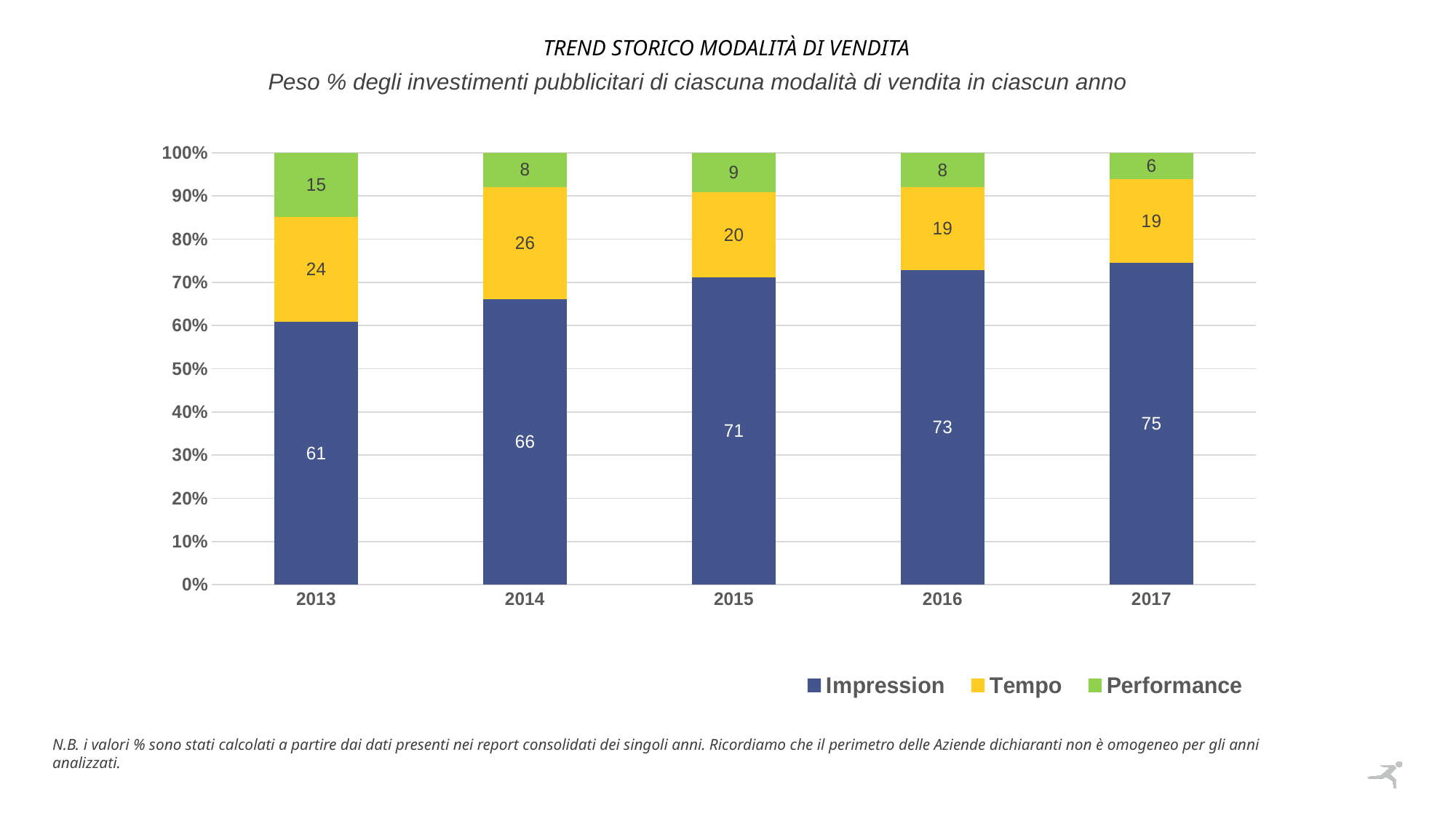
What is the Tempo value for 2014? 26 Which colour represents the Tempo series in the legend? Yellow What is the Performance value for 2013? 15 Do the Impression values rise or fall from 2013 to 2017? Rise What kind of chart is shown on the slide? Stacked bar chart Which is larger, the Tempo value for 2013 or the Tempo value for 2015? 2013 Which year has the lowest Performance value? 2017 Which year has the highest Impression value? 2017 What is the difference between the Impression values for 2017 and 2013? 14 How many series does the legend list? 3 What is the Impression value for 2015? 71 How many years are shown on the x axis? 5